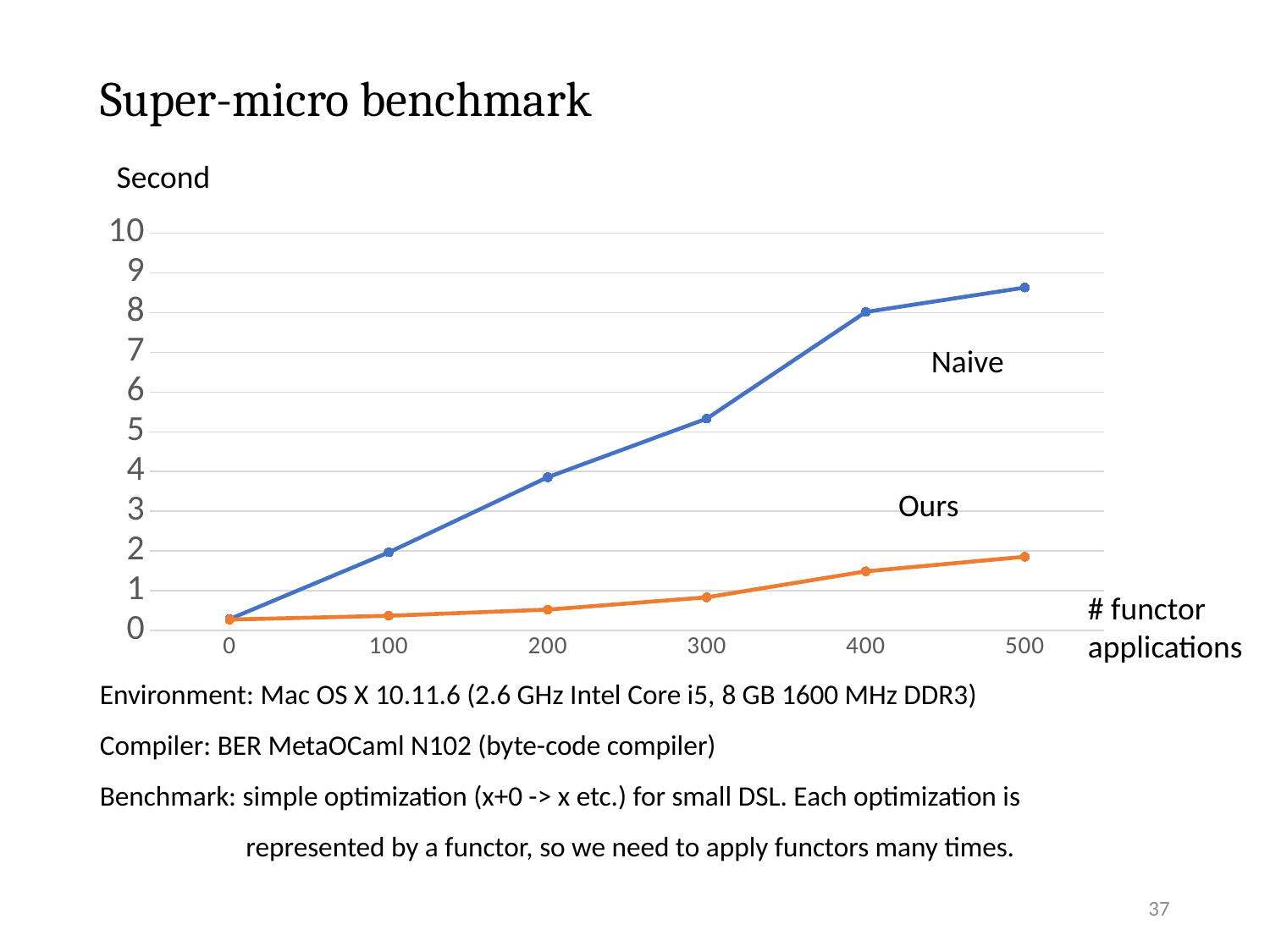
Is the value for Ours at 400 functor applications greater or less than 1? greater Is the value for Naive at 100 functor applications greater or less than 3? less How many series are plotted in the chart? 2 Is the value for Ours at 500 functor applications greater or less than 2? less What kind of chart is shown on the slide? line chart Does the Naive series rise or fall as the number of functor applications increases? rise What is the label on the vertical axis of the chart? Second At 500 functor applications, which series has the larger value, Naive or Ours? Naive How many data points does the Naive series have? 6 What is the label on the horizontal axis of the chart? # functor applications